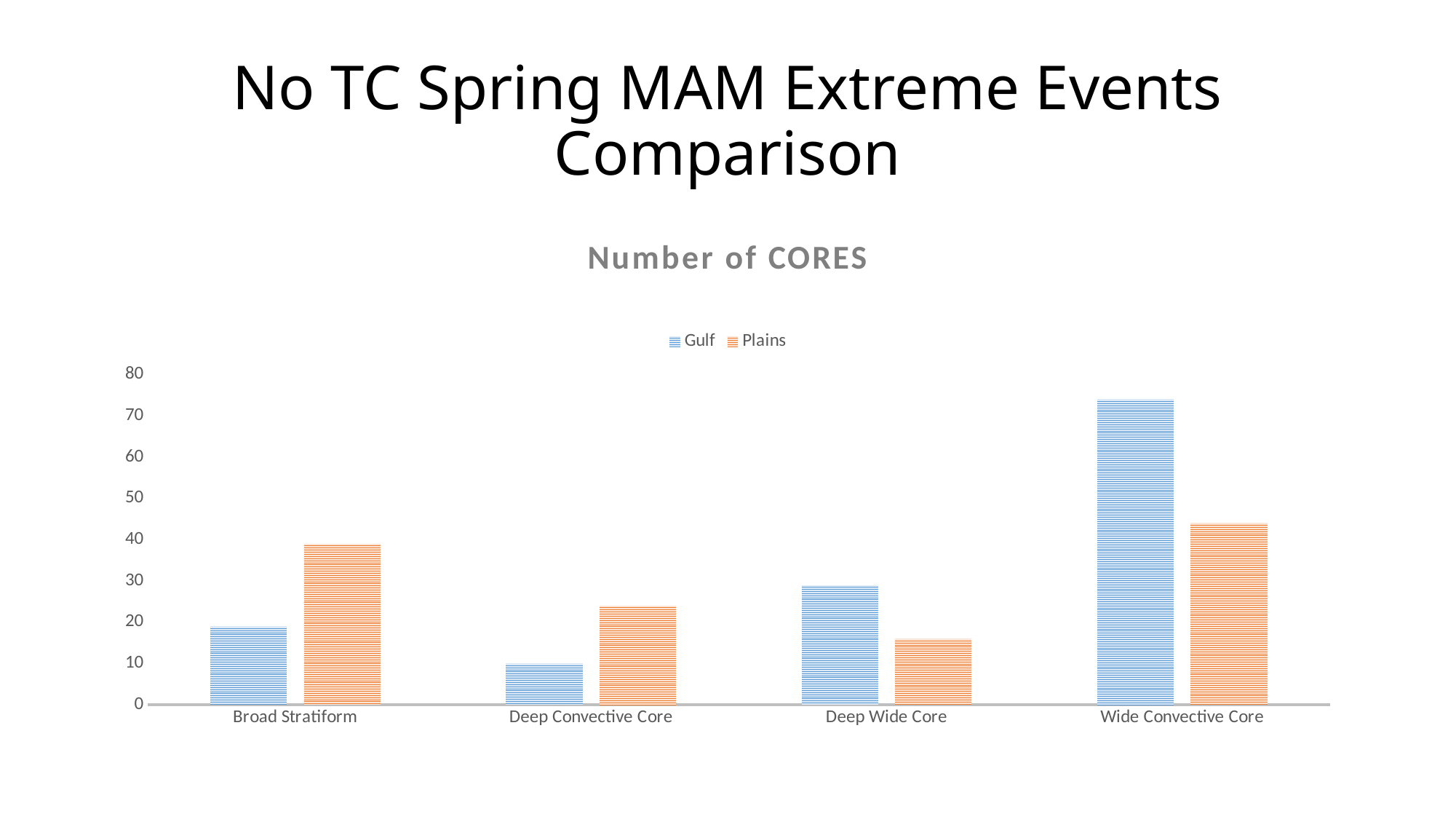
Which category has the lowest Gulf value? Deep Convective Core For Deep Wide Core, which series has the larger value, Gulf or Plains? Gulf Which category has the lowest Plains value? Deep Wide Core Which series is shown in orange? Plains How many series does the legend list? 2 Which category has the highest Gulf value? Wide Convective Core What is the title of the chart? Number of CORES Is the Gulf value for Wide Convective Core greater or less than 70? greater Which category has the highest Plains value? Wide Convective Core For Broad Stratiform, which series has the larger value, Gulf or Plains? Plains What kind of chart is shown on the slide? bar chart How many categories are shown on the x axis? 4